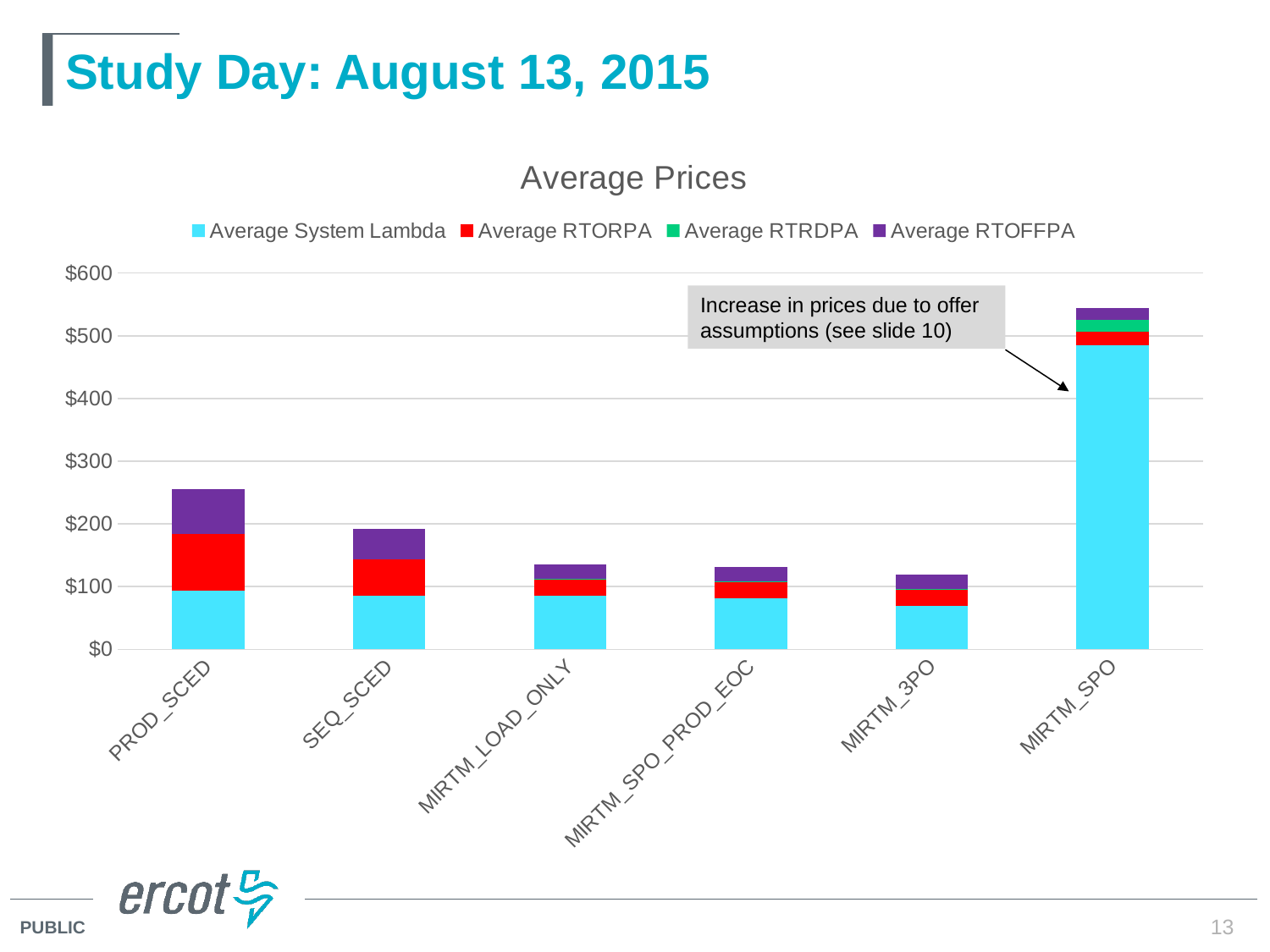
How many series does the legend list? 4 According to the annotation, what is the increase in prices for MIRTM_SPO due to? Offer assumptions (see slide 10) Which has the larger Average RTORPA segment, PROD_SCED or SEQ_SCED? PROD_SCED Which category has the highest total average price? MIRTM_SPO What is the title of the chart? Average Prices Is the Average System Lambda value for MIRTM_SPO greater or less than $400? greater Which has the larger total, PROD_SCED or SEQ_SCED? PROD_SCED How many categories are shown on the x axis? 6 Is the total for PROD_SCED greater or less than $200? greater Is the total for SEQ_SCED greater or less than $300? less What kind of chart is shown on the slide? Stacked bar chart